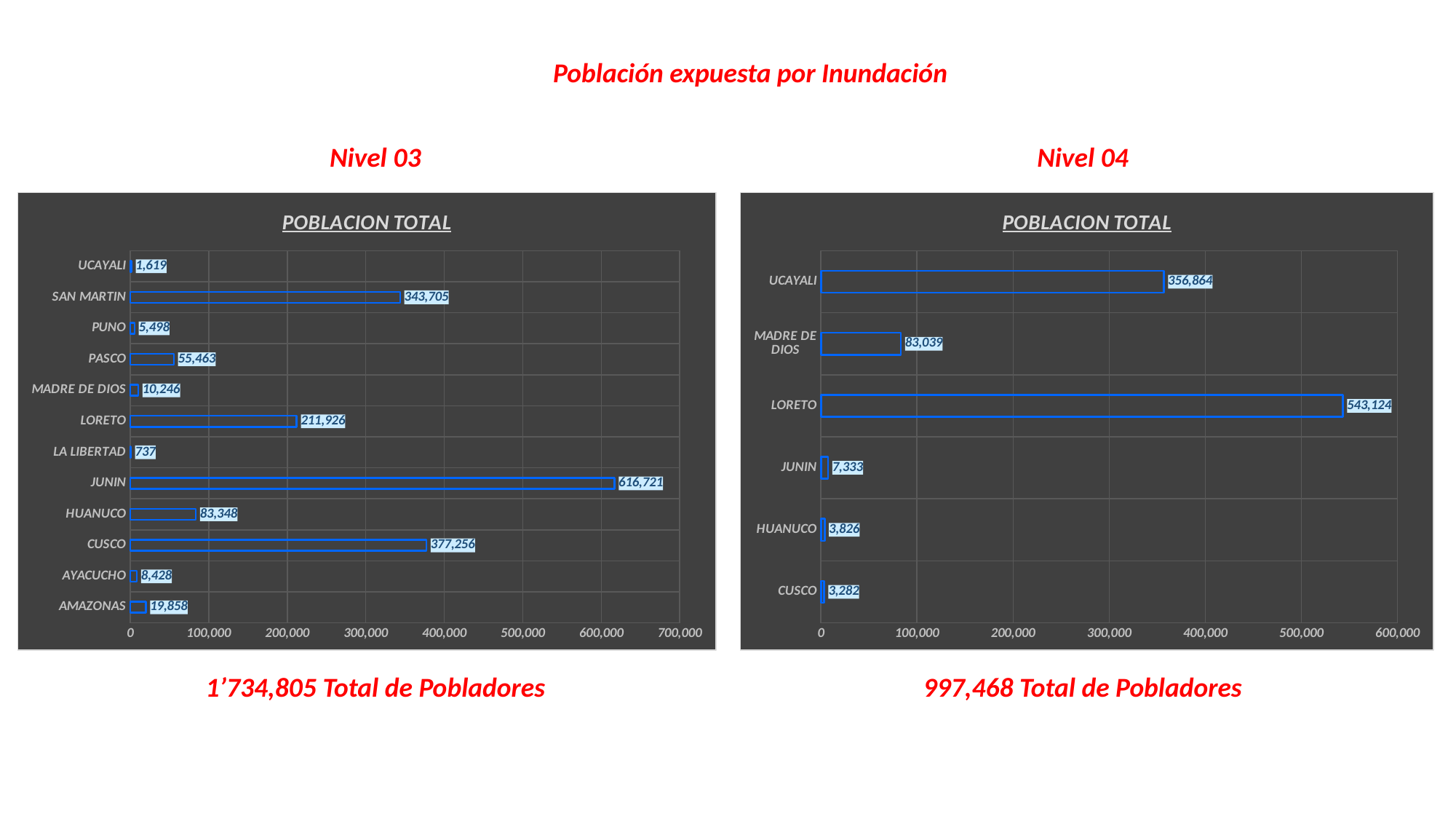
In the Nivel 04 chart, which region has the lowest value? CUSCO In the Nivel 03 chart, what is the difference between the values for CUSCO and SAN MARTIN? 33,551 In the Nivel 04 chart, what is the difference between the values for LORETO and UCAYALI? 186,260 What type of chart is the Nivel 04 chart? Bar chart How many regions are shown in the Nivel 04 chart? 6 In the Nivel 03 chart, what is the value for JUNIN? 616,721 In the Nivel 03 chart, which is larger, the value for HUANUCO or the value for PASCO? HUANUCO In the Nivel 04 chart, what is the value for MADRE DE DIOS? 83,039 In the Nivel 04 chart, which region has the highest value? LORETO In the Nivel 03 chart, which region has the lowest value? LA LIBERTAD In the Nivel 03 chart, what is the value for LORETO? 211,926 How many regions are shown in the Nivel 03 chart? 12